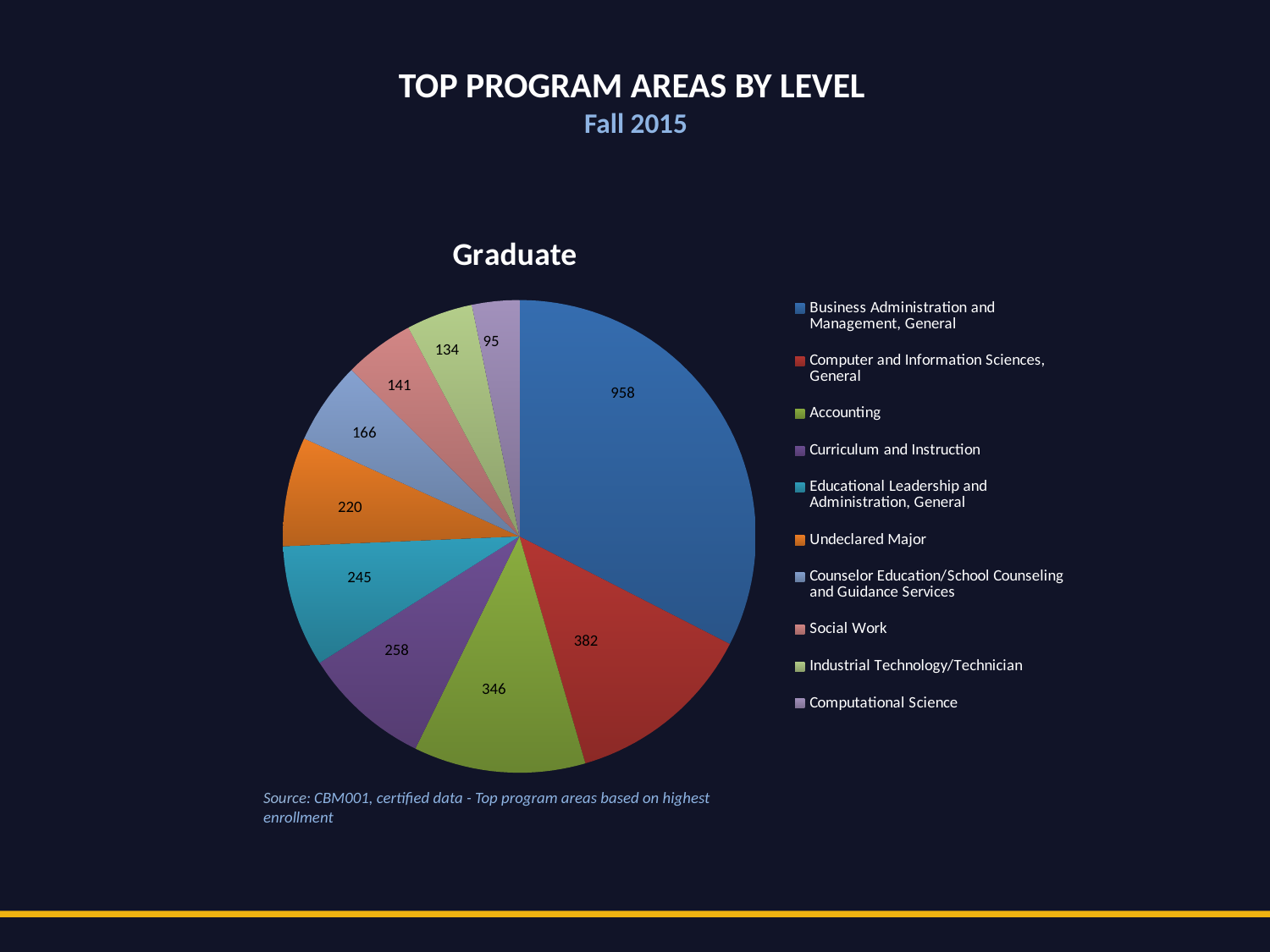
What is the value for Social Work in the Graduate pie chart? 141 Which program area has the smallest slice in the Graduate pie chart? Computational Science What type of chart is shown on the slide? Pie chart What is the value for Business Administration and Management, General in the Graduate pie chart? 958 Which program area has the largest slice in the Graduate pie chart? Business Administration and Management, General What is the difference between the values for Computer and Information Sciences, General and Accounting? 36 What is the difference between the values for Business Administration and Management, General and Computational Science? 863 What is the title of the pie chart on the slide? Graduate What is the value for Undeclared Major in the Graduate pie chart? 220 What is the value for Accounting in the Graduate pie chart? 346 Which is larger: Curriculum and Instruction or Educational Leadership and Administration, General? Curriculum and Instruction How many program areas are shown in the Graduate pie chart? 10